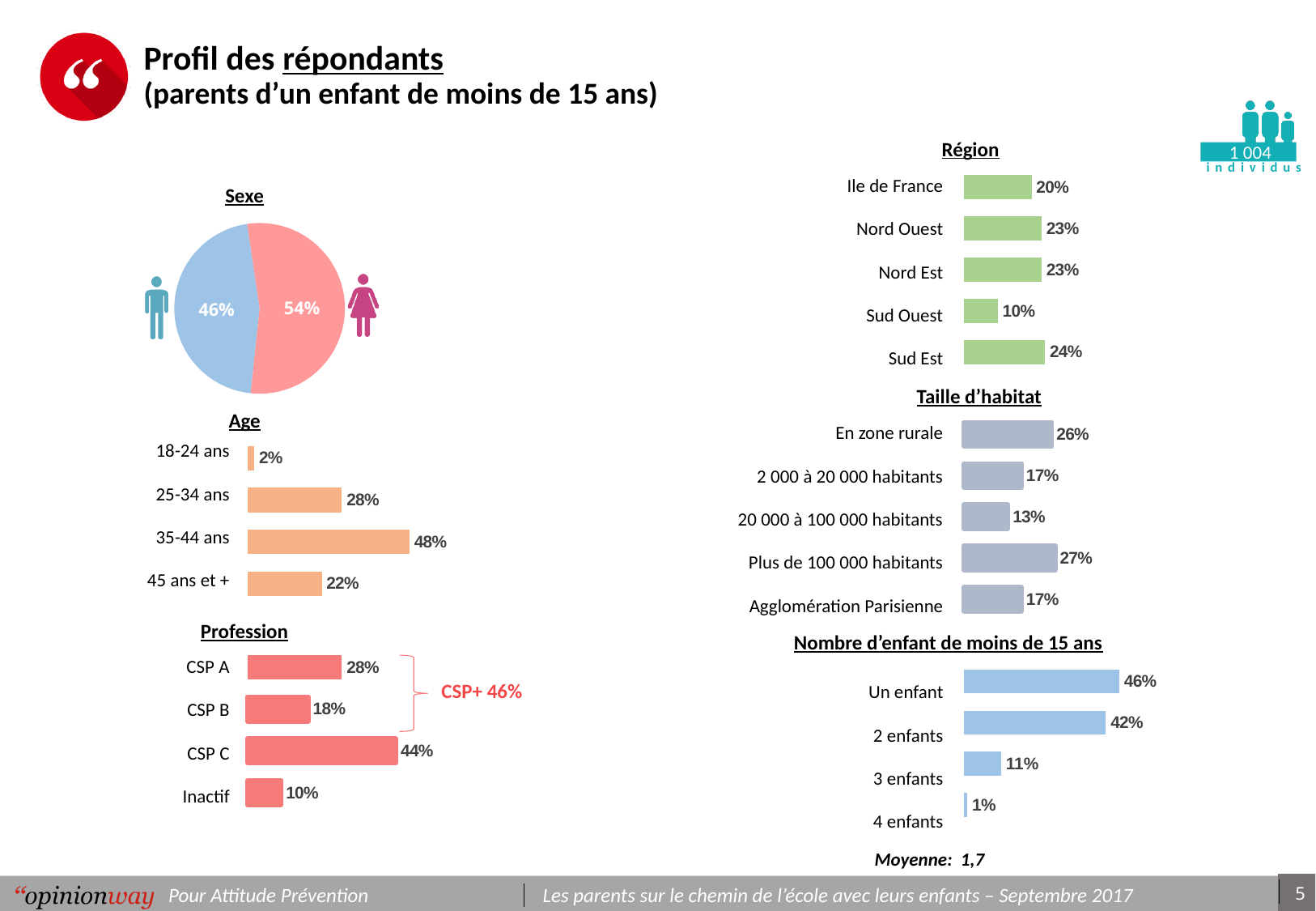
In the Age chart, which age group has the highest value? 35-44 ans In the Age chart, what is the value for 25-34 ans? 28% In the Taille d'habitat chart, which is larger: En zone rurale or 20 000 à 100 000 habitants? En zone rurale In the Région chart, how many regions are listed? 5 In the Sexe chart, what share of respondents are women (54% slice)? What is the value shown for the pink slice? 54% In the Profession chart, what is the combined value of CSP A and CSP B? 46% In the Sexe chart, what kind of chart is used? Pie chart In the Profession chart, which category has the lowest value? Inactif In the Nombre d'enfant de moins de 15 ans chart, what is the value for 3 enfants? 11% In the Age chart, what is the difference between 35-44 ans and 45 ans et +? 26% In the Région chart, which region has the lowest value? Sud Ouest In the Nombre d'enfant de moins de 15 ans chart, do the values rise or fall from Un enfant to 4 enfants? Fall